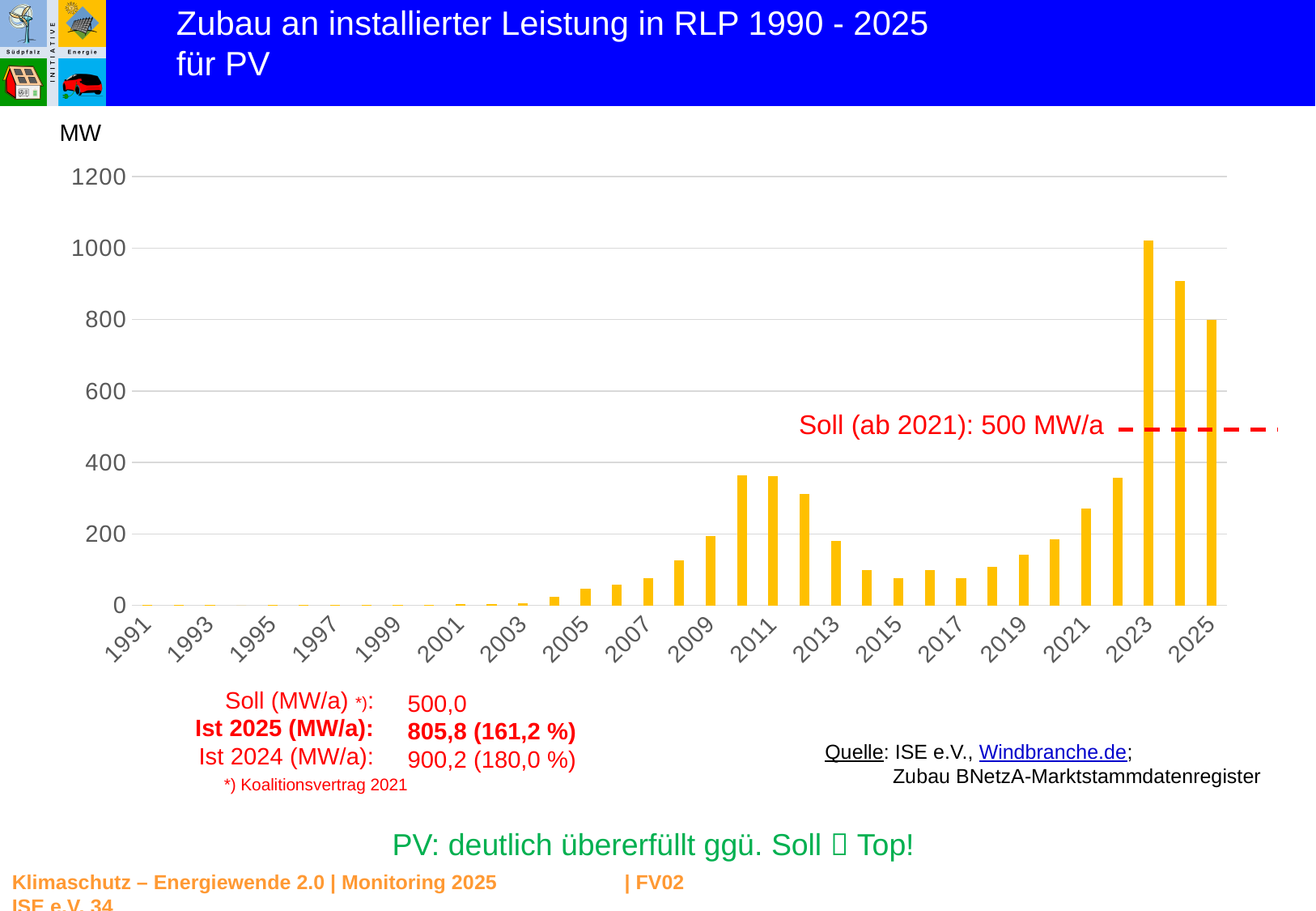
What target value (Soll) does the dashed red line mark from 2021 onwards? 500 MW/a Is the value for 2019 greater or less than 200? less Is the value for 2023 greater or less than 1000? greater Is the value for 2021 greater or less than 400? less According to the text below the chart, what is the Ist 2025 value in MW/a? 805,8 Which year has the highest PV capacity addition in the chart? 2023 Do the values rise or fall from 2019 to 2023? rise According to the text below the chart, what is the Ist 2024 value in MW/a? 900,2 Which year has the larger value, 2024 or 2025? 2024 What kind of chart is shown on the slide? bar chart